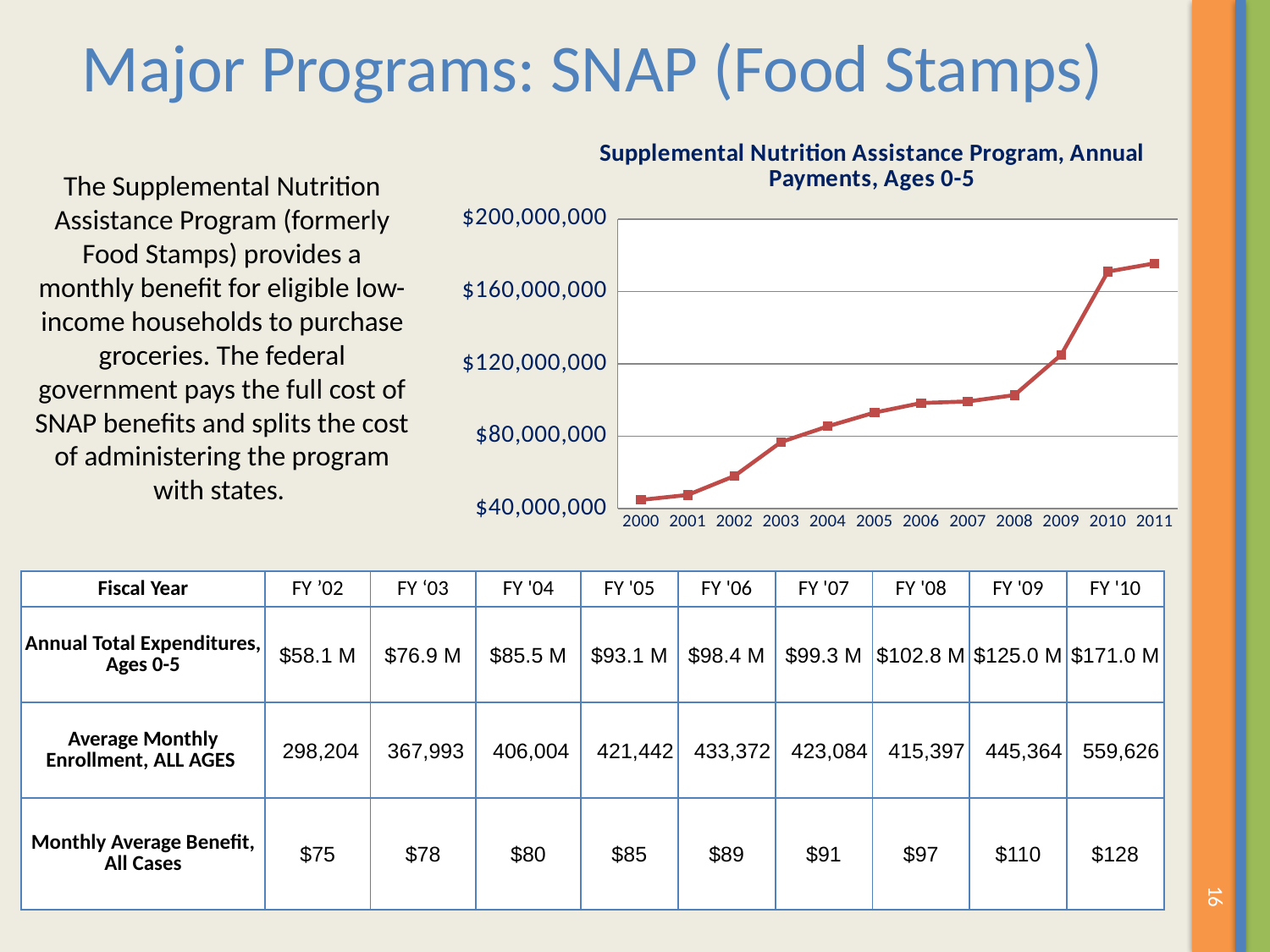
Which year has the lowest annual payment in the chart? 2000 Which year has the highest annual payment in the chart? 2011 How many years are plotted on the x axis of the chart? 12 Is the value for 2011 greater or less than $200,000,000? less Do the annual payments in the chart generally rise or fall from 2000 to 2011? Rise What kind of chart is shown on the slide? Line chart Which year has the larger annual payment, 2009 or 2010? 2010 Is the value for 2002 greater or less than $80,000,000? less Is the value for 2008 greater or less than $120,000,000? less What colour is the line in the chart? Red What is the title of the chart? Supplemental Nutrition Assistance Program, Annual Payments, Ages 0-5